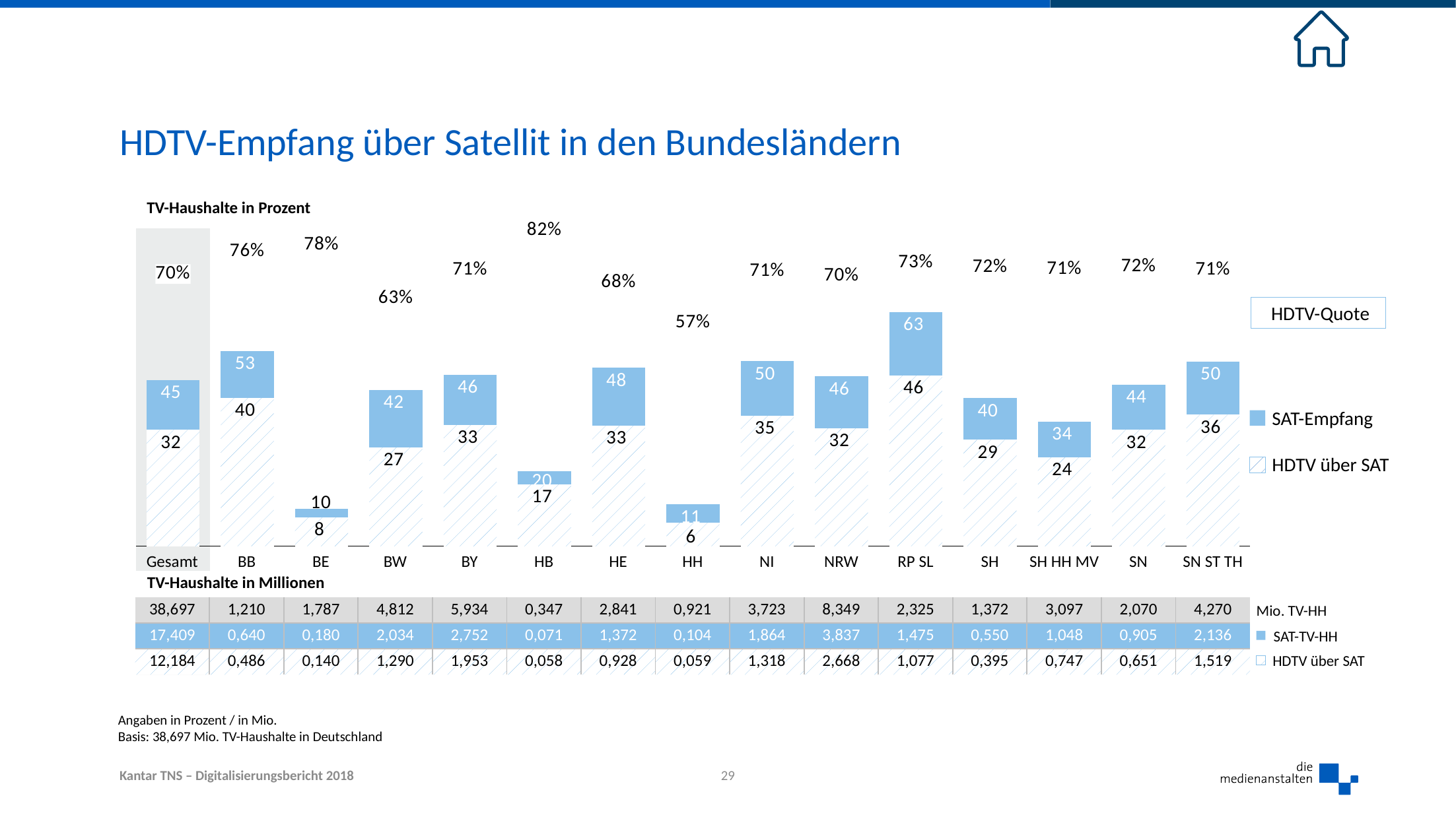
Which has the larger SAT-Empfang value, BB or NI? BB What is the HDTV über SAT value for NRW? 32 What is the HDTV über SAT value for HH? 6 What is the SAT-Empfang value for BY? 46 Which category has the highest SAT-Empfang value? RP SL What is the HDTV-Quote shown for Gesamt? 70% How many categories are shown along the x axis of the chart? 15 Which category has the highest HDTV-Quote? HB Which category has the lowest HDTV-Quote? HH What is the HDTV-Quote shown for HB? 82% What is the difference between the SAT-Empfang value and the HDTV über SAT value for BB? 13 What kind of chart is shown on the slide? bar chart